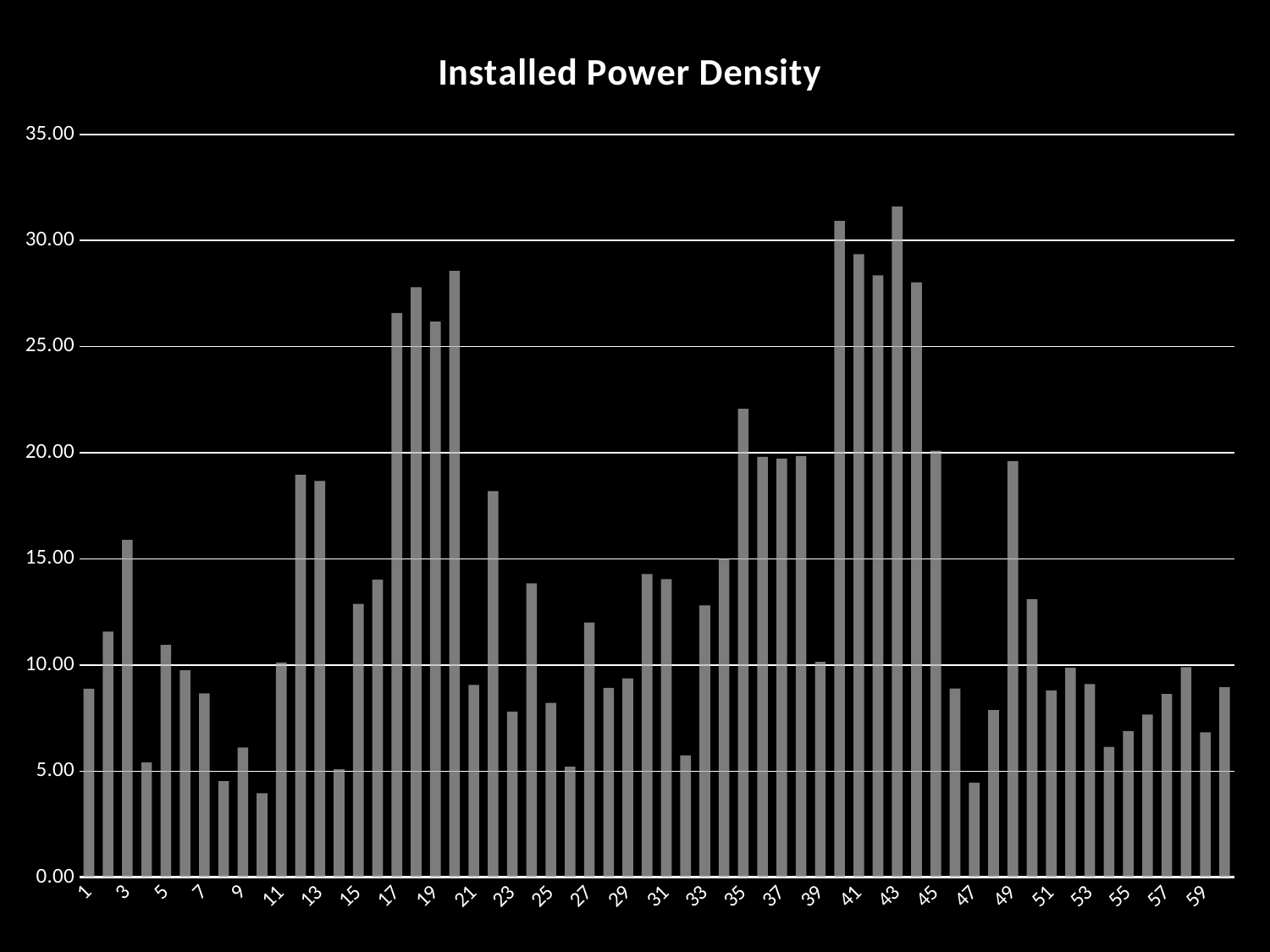
How many bars are plotted in the chart? 60 Which category has the highest value in the chart? 43 Which is larger, the value for category 3 or the value for category 5? 3 Is the value for category 41 greater or less than 30.00? less Is the value for category 10 greater or less than 5.00? less Is the value for category 35 greater or less than 20.00? greater What kind of chart is shown on the slide? bar chart What is the title of the chart? Installed Power Density Which is larger, the value for category 20 or the value for category 17? 20